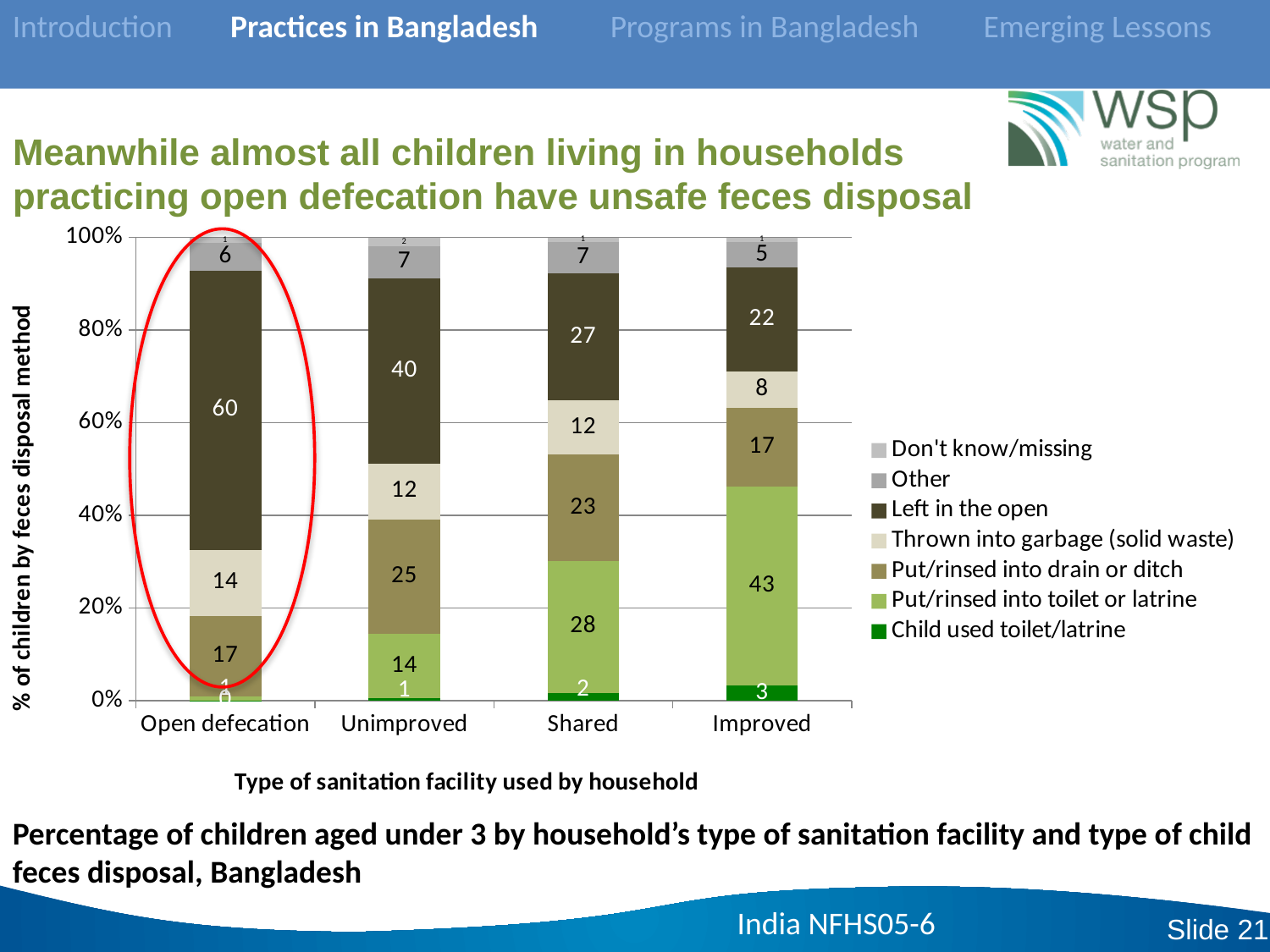
Does the 'Left in the open' value rise or fall moving from Open defecation to Improved along the x axis? Fall Which category has the lowest value for 'Put/rinsed into toilet or latrine'? Open defecation How many types of sanitation facility are shown on the x axis? 4 What percentage of children in households practicing open defecation have feces left in the open? 60 What is the difference between the 'Left in the open' values for Open defecation and Unimproved? 20 What is the value for 'Left in the open' in the Unimproved category? 40 How many series does the legend list? 7 What type of chart is shown on the slide? Stacked bar chart What is the value for 'Put/rinsed into toilet or latrine' in the Improved category? 43 Is the 'Left in the open' value larger for Shared or for Improved? Shared What is the value for 'Put/rinsed into drain or ditch' in the Unimproved category? 25 Which sanitation facility category has the highest value for 'Left in the open'? Open defecation